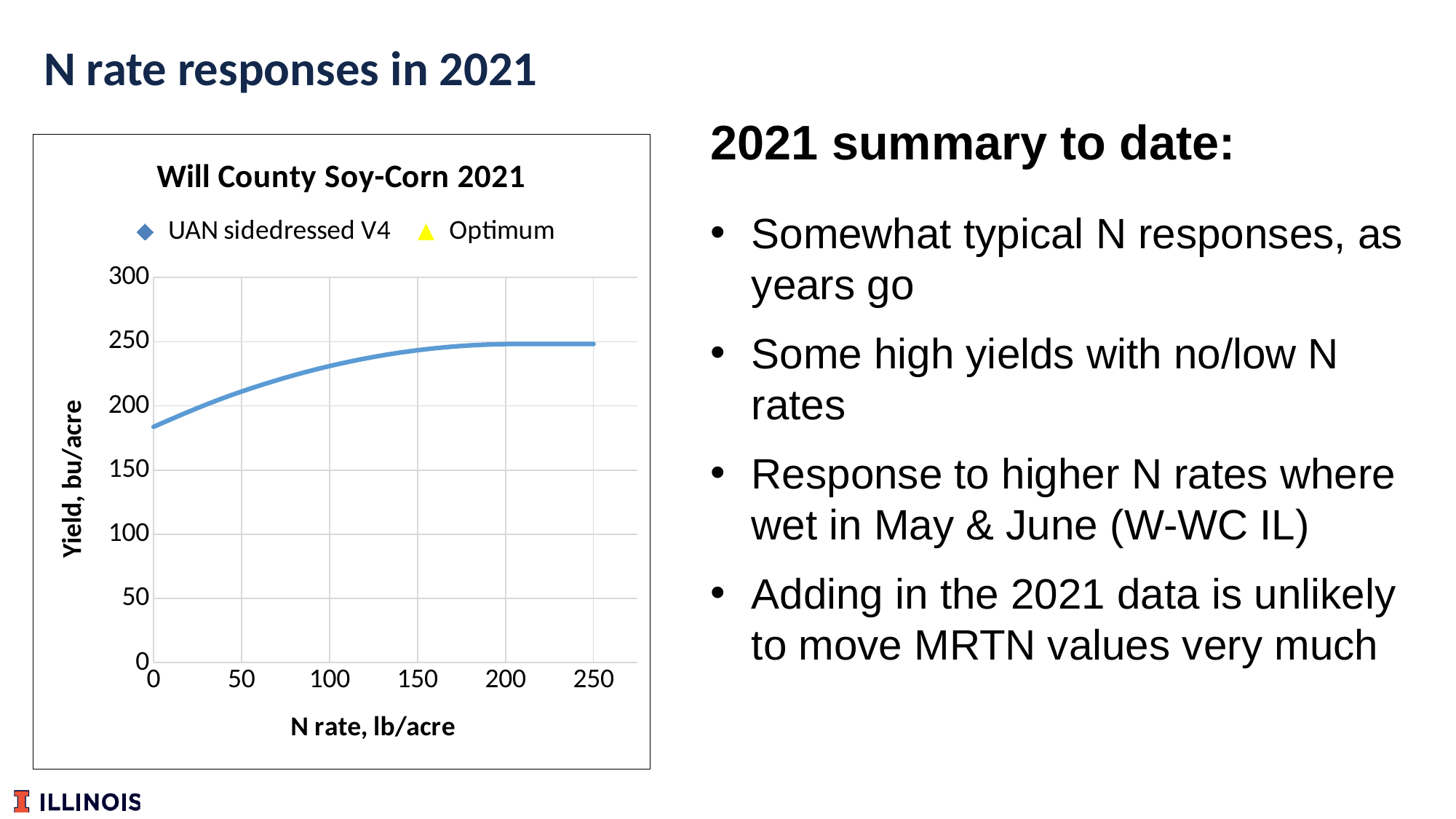
What kind of chart is shown on the slide? line chart Is the yield for UAN sidedressed V4 at an N rate of 0 greater or less than 150? greater How many series does the chart legend list? 2 Does the yield for UAN sidedressed V4 rise or fall as the N rate increases from 0 to 250? rise At which N rate is the yield for UAN sidedressed V4 lowest? 0 Is the yield for UAN sidedressed V4 at an N rate of 0 greater or less than 200? less Is the yield for UAN sidedressed V4 at an N rate of 100 greater or less than 200? greater Which is larger for UAN sidedressed V4: the yield at an N rate of 0 or at an N rate of 250? 250 What is the title of the chart? Will County Soy-Corn 2021 What is the label of the y axis? Yield, bu/acre